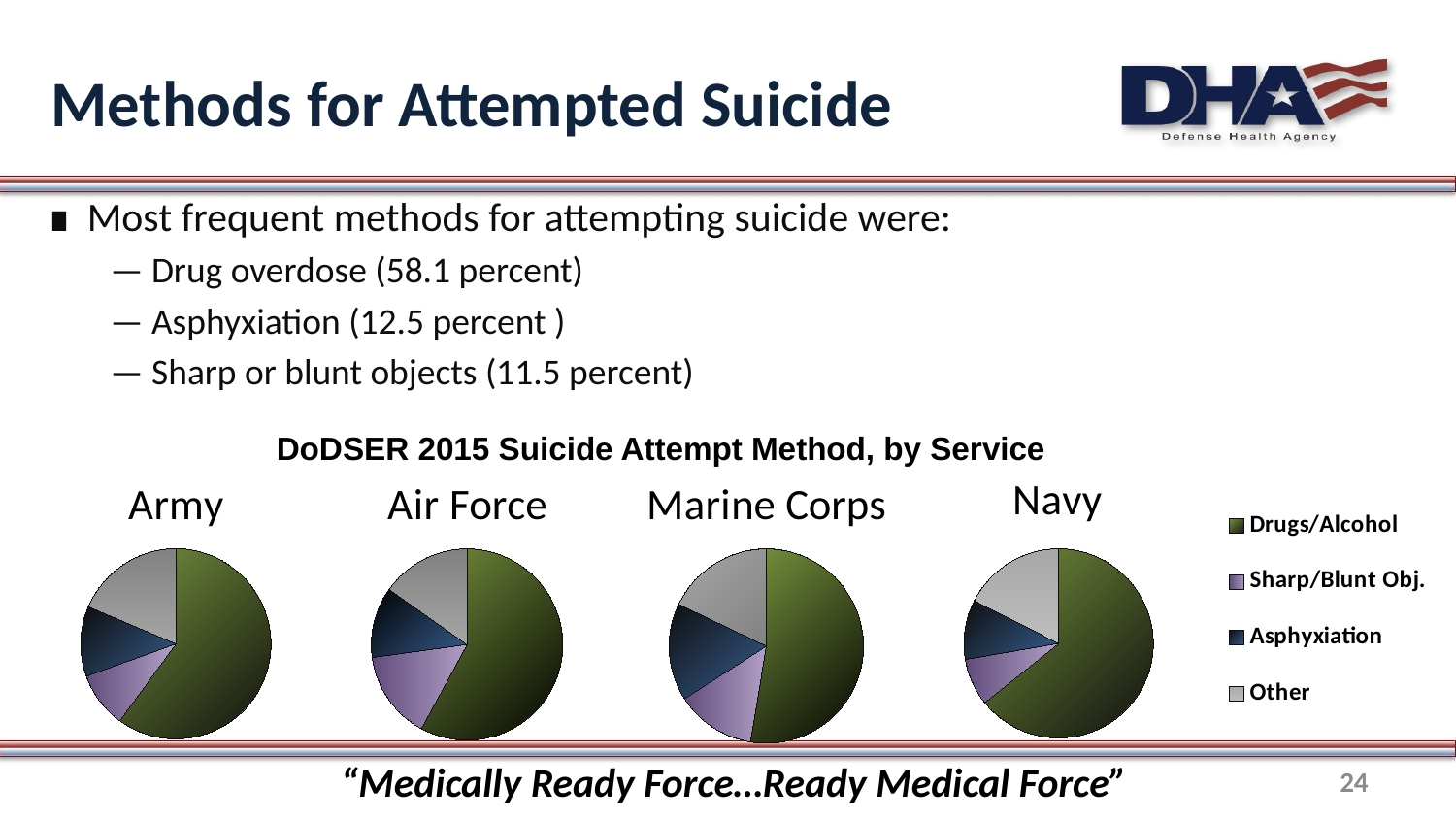
In the Army pie chart, which method has the smallest slice? Sharp/Blunt Obj. In the Air Force pie chart, which method has the smallest slice? Asphyxiation In the Marine Corps pie chart, which slice is larger: Drugs/Alcohol or Other? Drugs/Alcohol What kind of charts are shown under the title 'DoDSER 2015 Suicide Attempt Method, by Service'? Pie charts In the Army pie chart, which method has the largest slice? Drugs/Alcohol In the Navy pie chart, which method has the largest slice? Drugs/Alcohol How many pie charts are shown on the slide? 4 In the Army pie chart, which slice is larger: Other or Sharp/Blunt Obj.? Other What is the title of the group of pie charts? DoDSER 2015 Suicide Attempt Method, by Service In the Navy pie chart, which method has the smallest slice? Sharp/Blunt Obj. Which legend entry is shown in green in the pie charts? Drugs/Alcohol How many categories does the legend list for the pie charts? 4